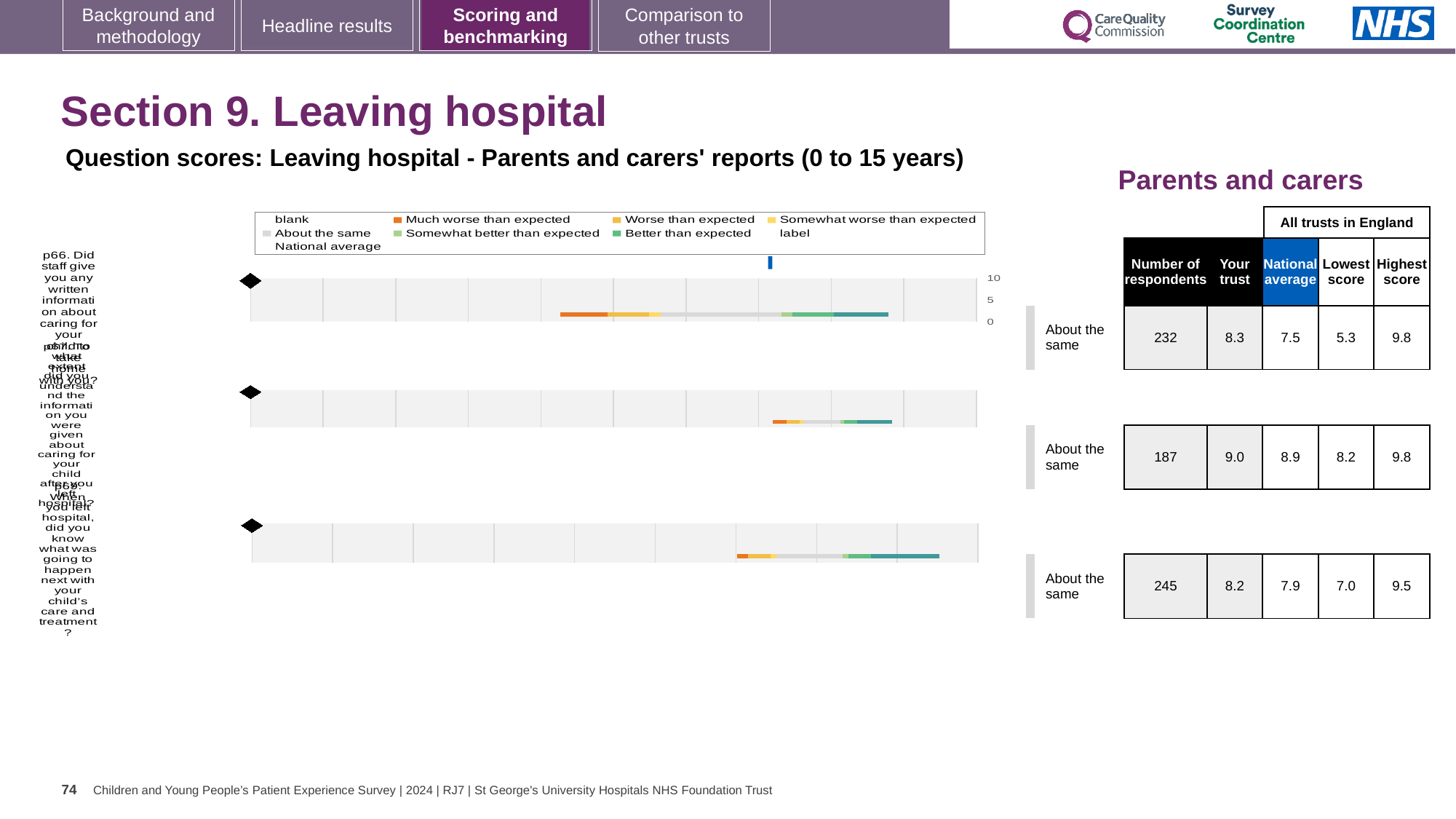
Which of the three charts has the highest 'Your trust' score? the middle chart (9.0) For the top chart (p66), what is the highest score among all trusts in England? 9.8 What benchmark category is shown next to each of the three charts? About the same For the middle chart, how many respondents are listed in the table? 187 For the bottom chart (p68), what is the lowest score among all trusts in England? 7.0 For the top chart (p66, written information about caring for your child), what is the 'Your trust' score shown in the table? 8.3 What kind of chart is used to show the question scores on this slide? bar chart For the top chart (p66), what is the difference between the 'Your trust' score and the national average? 0.8 In the chart legend, which category is shown in orange? Much worse than expected For the bottom chart (p68, knowing what was going to happen next), what is the national average score? 7.9 For the bottom chart (p68), which is larger: the 'Your trust' score or the national average? Your trust How many question score charts (bars) are shown on the slide? 3